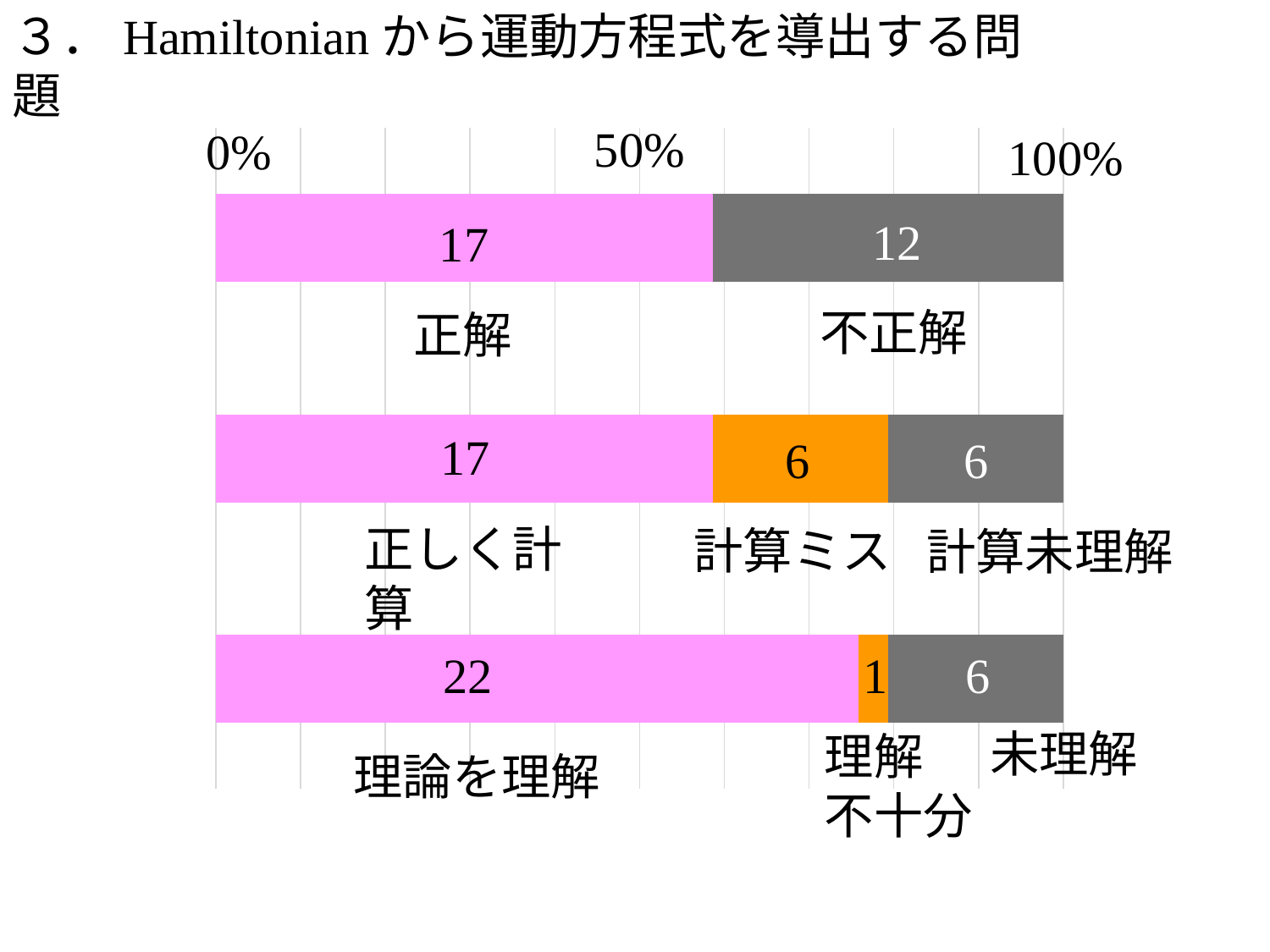
What is the value of the 計算ミス segment in the middle bar? 6 What is the value of the 理論を理解 segment in the bottom bar? 22 What is the value of the 不正解 segment in the top bar? 12 What is the value of the 正解 segment in the top bar? 17 What is the value of the 理解不十分 segment in the bottom bar? 1 How many stacked bars does the chart contain? 3 What is the difference between the 正解 and 不正解 values in the top bar? 5 Which is larger in the bottom bar, 理論を理解 or 未理解? 理論を理解 Which segment in the bottom bar has the smallest value? 理解不十分 What is the total of the middle bar (正しく計算, 計算ミス and 計算未理解)? 29 What kind of chart is shown on the slide? stacked bar chart What is the total of the top bar (正解 plus 不正解)? 29